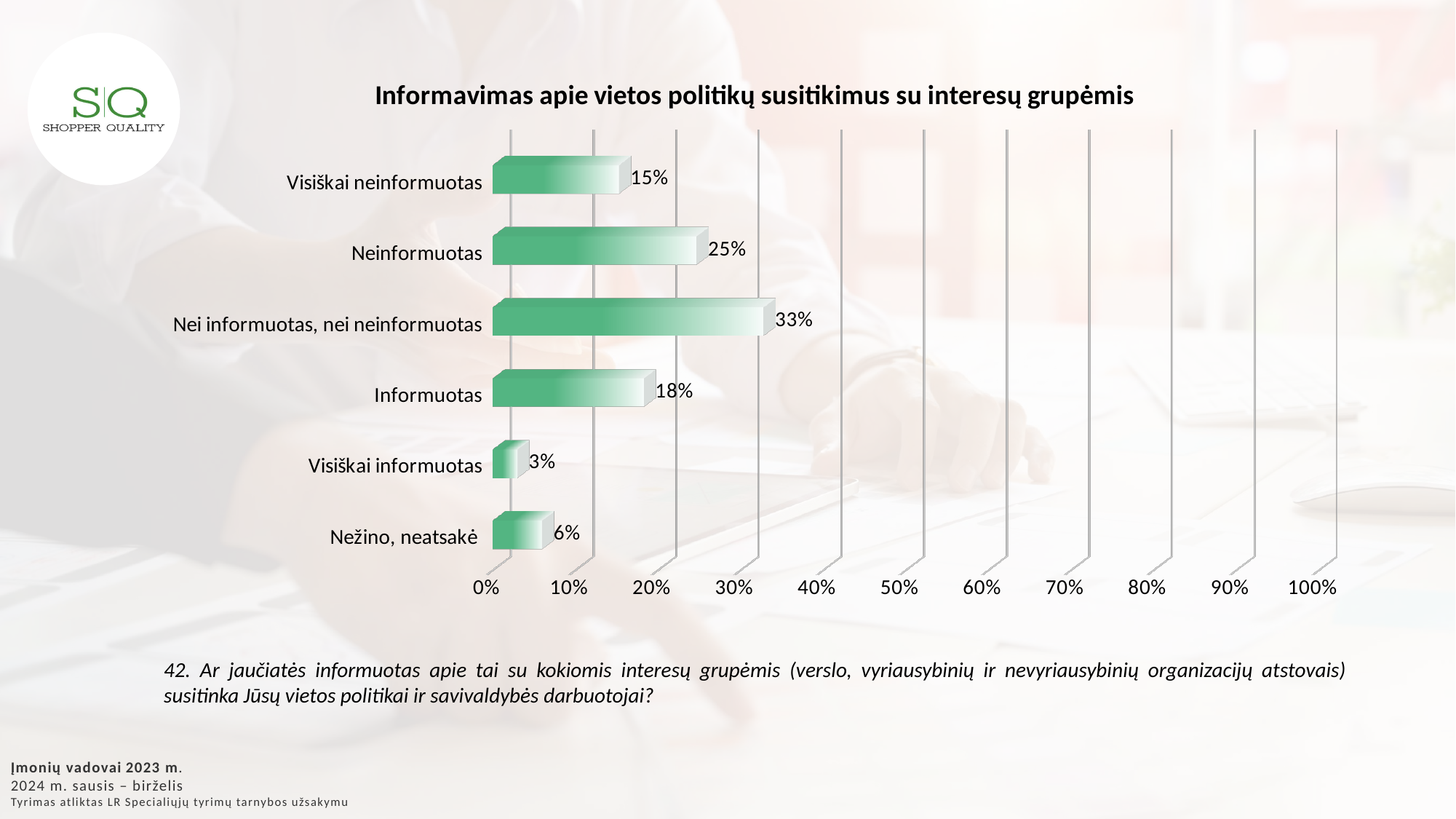
Which category has the highest value? Nei informuotas, nei neinformuotas What kind of chart is shown on the slide? bar chart How many categories are shown in the chart? 6 What is the highest value shown on the x axis? 100% What is the difference between the values for "Neinformuotas" and "Informuotas"? 7% Which category has the lowest value? Visiškai informuotas Is the value for "Nei informuotas, nei neinformuotas" greater or less than 30%? greater What is the value for "Nežino, neatsakė"? 6% Which is larger, the value for "Neinformuotas" or the value for "Visiškai neinformuotas"? Neinformuotas What is the title of the chart? Informavimas apie vietos politikų susitikimus su interesų grupėmis What is the value for "Nei informuotas, nei neinformuotas"? 33% What is the value for "Visiškai neinformuotas"? 15%